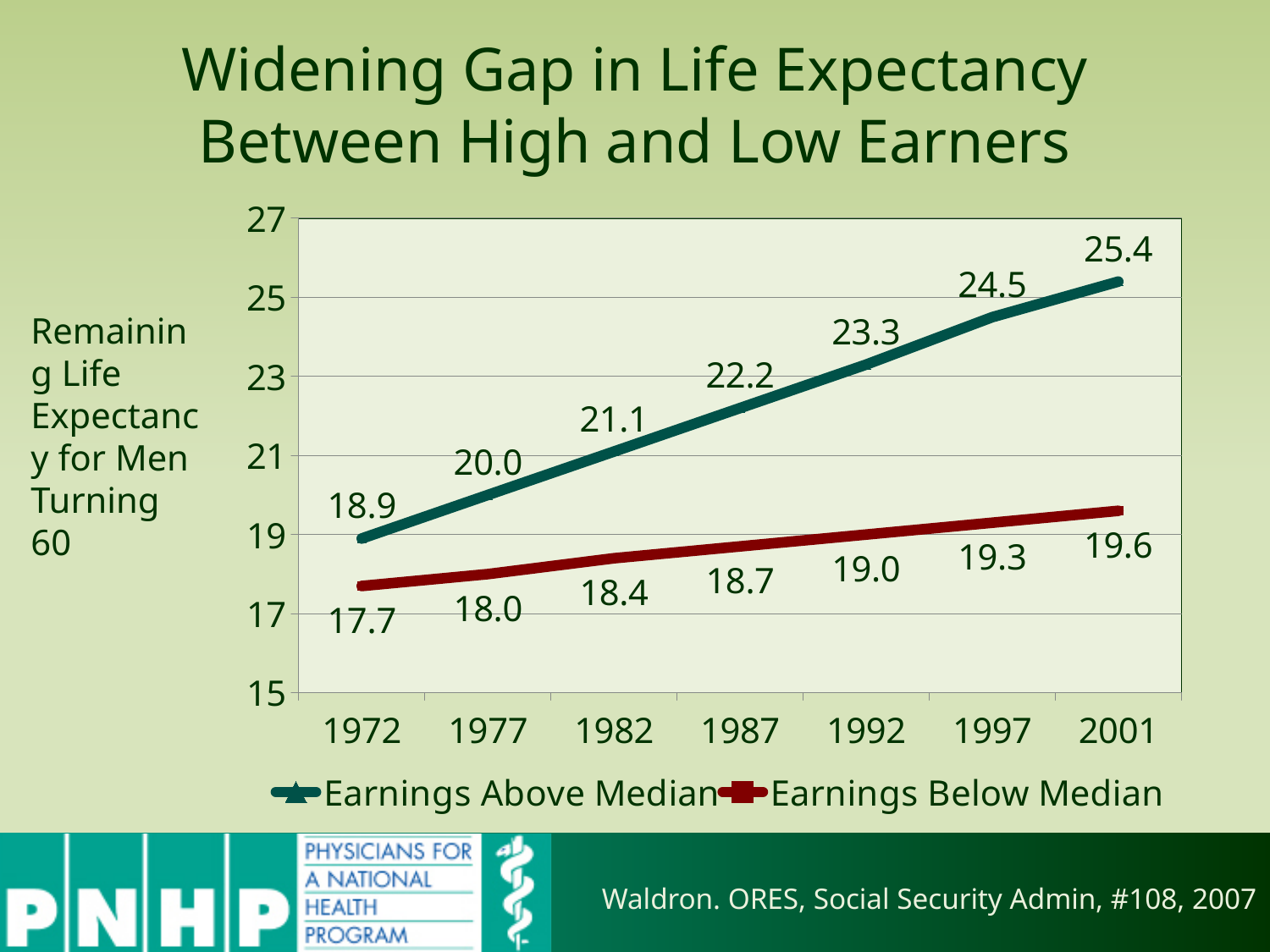
What is the value for Earnings Below Median in 1992? 19.0 What is the remaining life expectancy for men with earnings below the median in 1972? 17.7 What is the difference between the Earnings Above Median and Earnings Below Median values in 1972? 1.2 In which year is the Earnings Above Median series at its highest? 2001 What is the difference between the Earnings Above Median and Earnings Below Median values in 2001? 5.8 How many series does the legend list? 2 What is the value for Earnings Above Median in 1987? 22.2 Which series has the larger value in 1997, Earnings Above Median or Earnings Below Median? Earnings Above Median How many years are shown on the x axis? 7 What is the remaining life expectancy for men with earnings above the median in 2001? 25.4 What kind of chart is shown on the slide? Line chart In which year is the Earnings Below Median series at its lowest? 1972